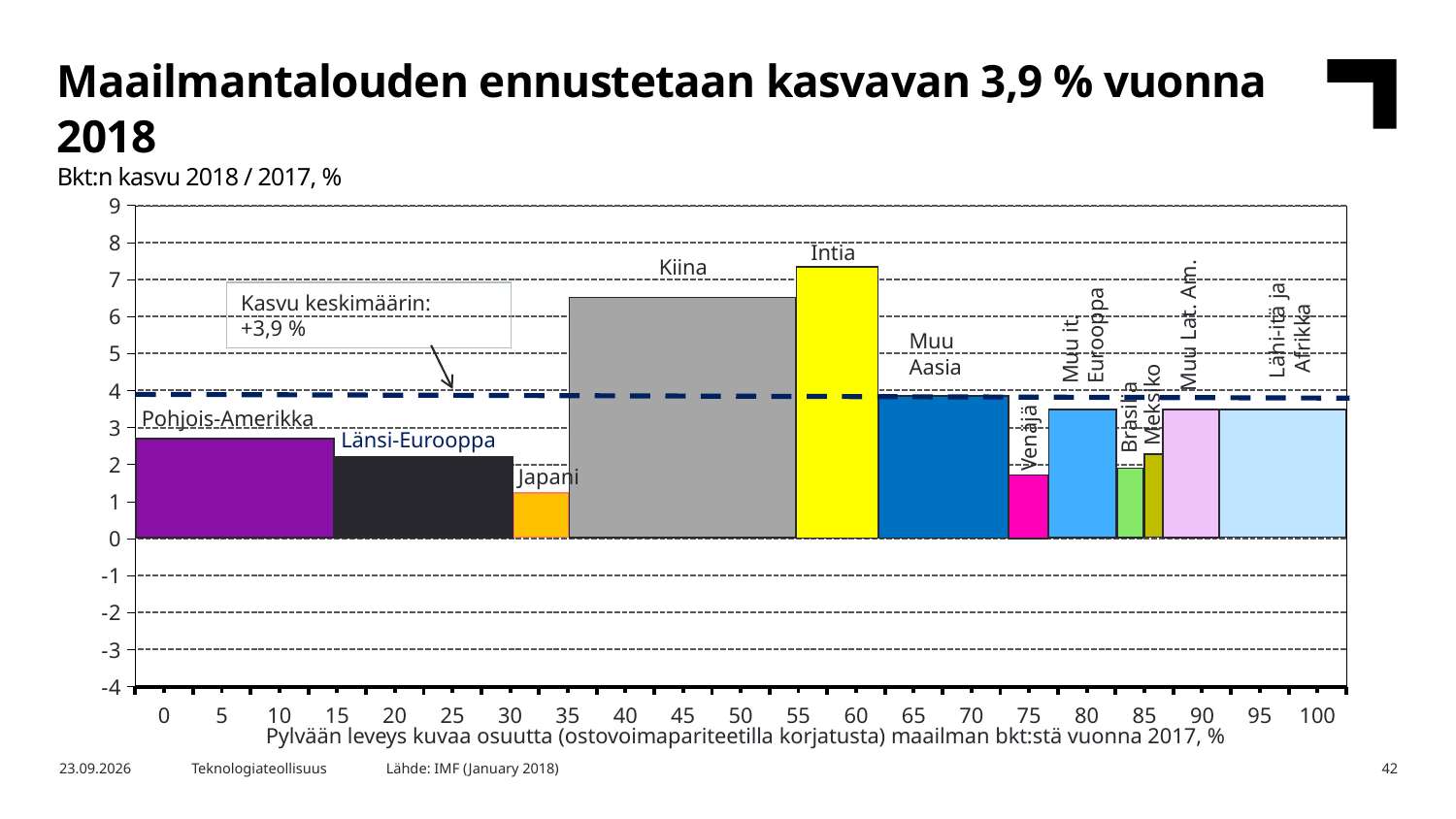
What is the subtitle of the chart, shown above the plot area? Bkt:n kasvu 2018 / 2017, % Is the value for Venäjä greater or less than 2? less Which has the higher value, Pohjois-Amerikka or Länsi-Eurooppa? Pohjois-Amerikka Which region has the highest GDP growth in the chart? Intia How many regions are plotted as bars in the chart? 12 Is the value for Japani greater or less than 2? less Is the value for Pohjois-Amerikka greater or less than 3? less Which has the higher value, Kiina or Intia? Intia Which region has the lowest GDP growth in the chart? Japani What average growth (Kasvu keskimäärin) is stated in the chart annotation? +3,9 % What kind of chart is shown on the slide? bar chart